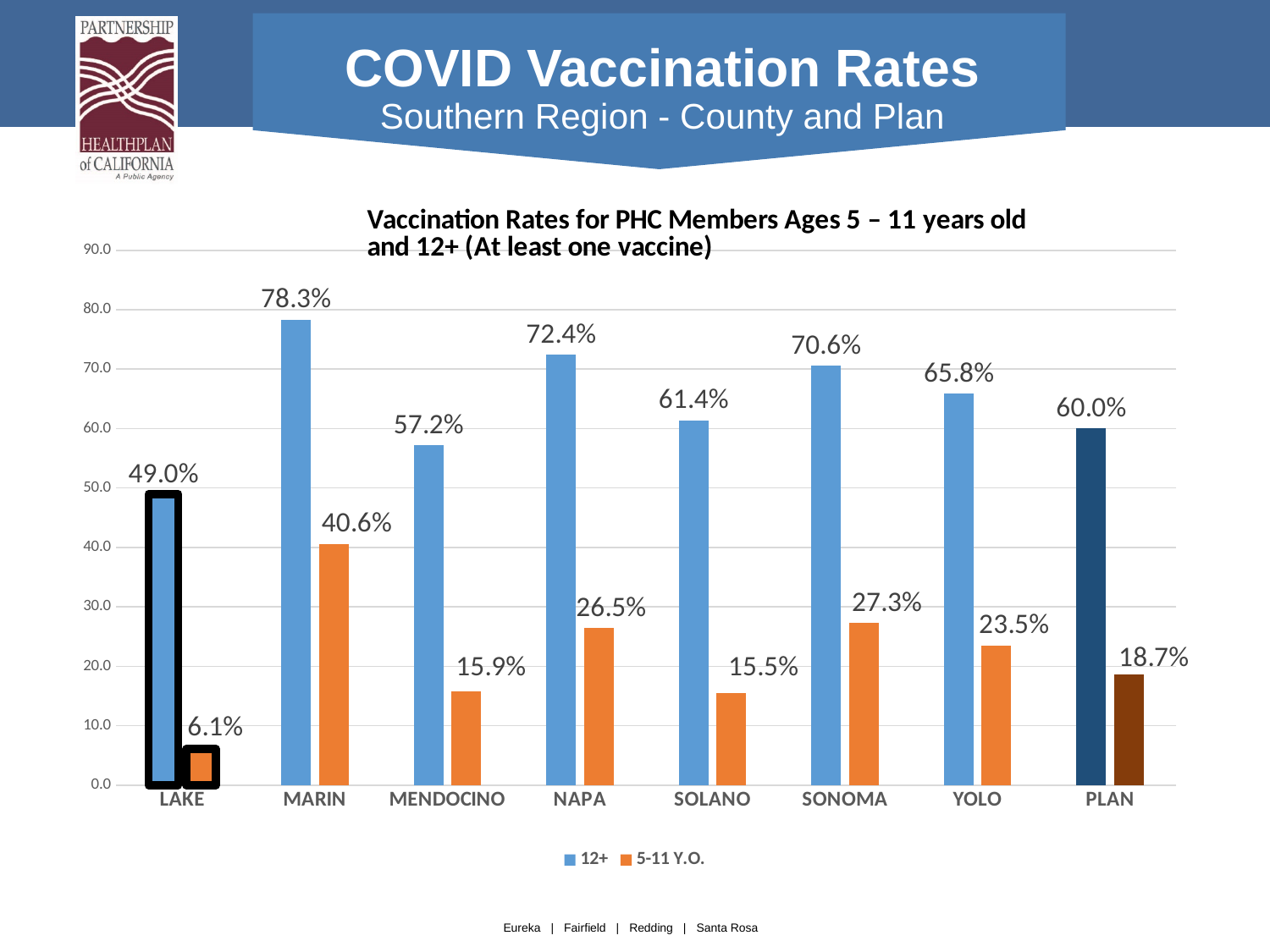
How many series does the legend list? 2 What is the title of the chart? Vaccination Rates for PHC Members Ages 5 – 11 years old and 12+ (At least one vaccine) What is the 5-11 Y.O. vaccination rate for Lake? 6.1% What is the 12+ vaccination rate for Plan? 60.0% What kind of chart is shown on the slide? Bar chart Which county has the highest 12+ vaccination rate? Marin What is the 12+ vaccination rate for Marin? 78.3% What is the 5-11 Y.O. vaccination rate for Sonoma? 27.3% Which category has the lowest 5-11 Y.O. vaccination rate? Lake What is the difference between the 12+ and 5-11 Y.O. rates for Napa? 45.9% Which has a higher 5-11 Y.O. vaccination rate, Yolo or Mendocino? Yolo How many categories are shown on the x axis? 8